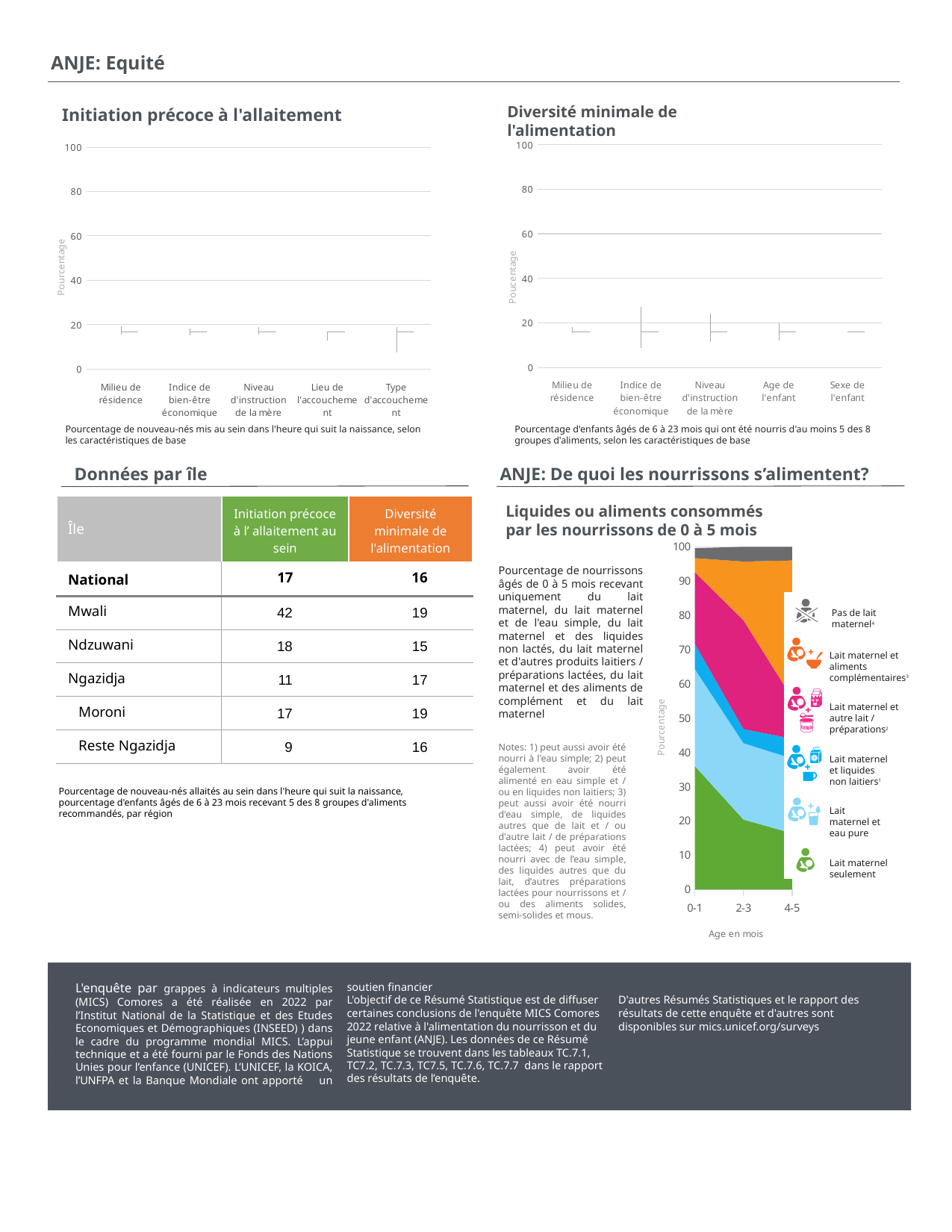
How many categories are shown on the x axis of the 'Diversité minimale de l'alimentation' chart? 5 In the 'Diversité minimale de l'alimentation' chart, is the value for Sexe de l'enfant greater or less than 40? less In the 'Liquides ou aliments consommés par les nourrissons de 0 à 5 mois' chart, does the share of 'Lait maternel et aliments complémentaires' rise or fall from 0-1 months to 4-5 months? rise How many series does the legend of the 'Liquides ou aliments consommés par les nourrissons de 0 à 5 mois' chart list? 6 How many age groups are shown on the x axis of the 'Liquides ou aliments consommés par les nourrissons de 0 à 5 mois' chart? 3 What is the x-axis label of the 'Liquides ou aliments consommés par les nourrissons de 0 à 5 mois' chart? Age en mois In the 'Initiation précoce à l'allaitement' chart, is the value for Milieu de résidence greater or less than 40? less What is the highest value shown on the y axis of the 'Diversité minimale de l'alimentation' chart? 100 In the 'Liquides ou aliments consommés par les nourrissons de 0 à 5 mois' chart, does the share of 'Lait maternel seulement' rise or fall from 0-1 months to 4-5 months? fall What is the y-axis label of the 'Initiation précoce à l'allaitement' chart? Pourcentage How many categories are shown on the x axis of the 'Initiation précoce à l'allaitement' chart? 5 What kind of chart is 'Liquides ou aliments consommés par les nourrissons de 0 à 5 mois'? stacked area chart